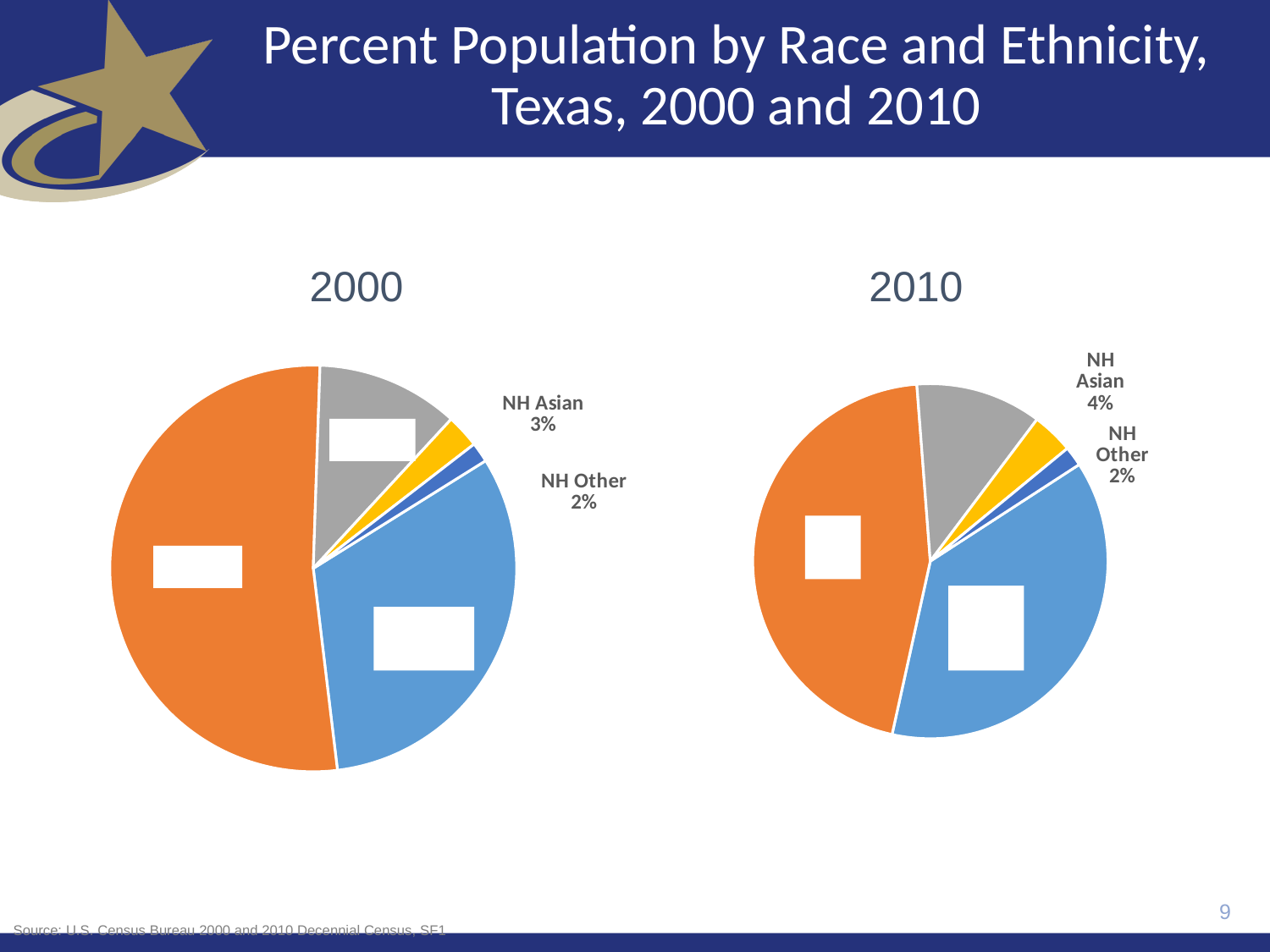
What is the difference between the NH Asian share in the 2010 pie chart and the NH Asian share in the 2000 pie chart? 1% In the 2010 pie chart, what percentage is shown for NH Asian? 4% In the 2010 pie chart, which is larger, NH Asian or NH Other? NH Asian How many slices does the 2010 pie chart have? 5 In the 2000 pie chart, what percentage is shown for NH Asian? 3% What kind of chart is used for the 2000 data on the slide? Pie chart In the 2000 pie chart, what is the difference between the NH Asian and NH Other shares? 1% What is the title of the slide containing the two pie charts? Percent Population by Race and Ethnicity, Texas, 2000 and 2010 In the 2000 pie chart, which is larger, NH Asian or NH Other? NH Asian In the 2000 pie chart, what percentage is shown for NH Other? 2% How many slices does the 2000 pie chart have? 5 In the 2010 pie chart, what percentage is shown for NH Other? 2%